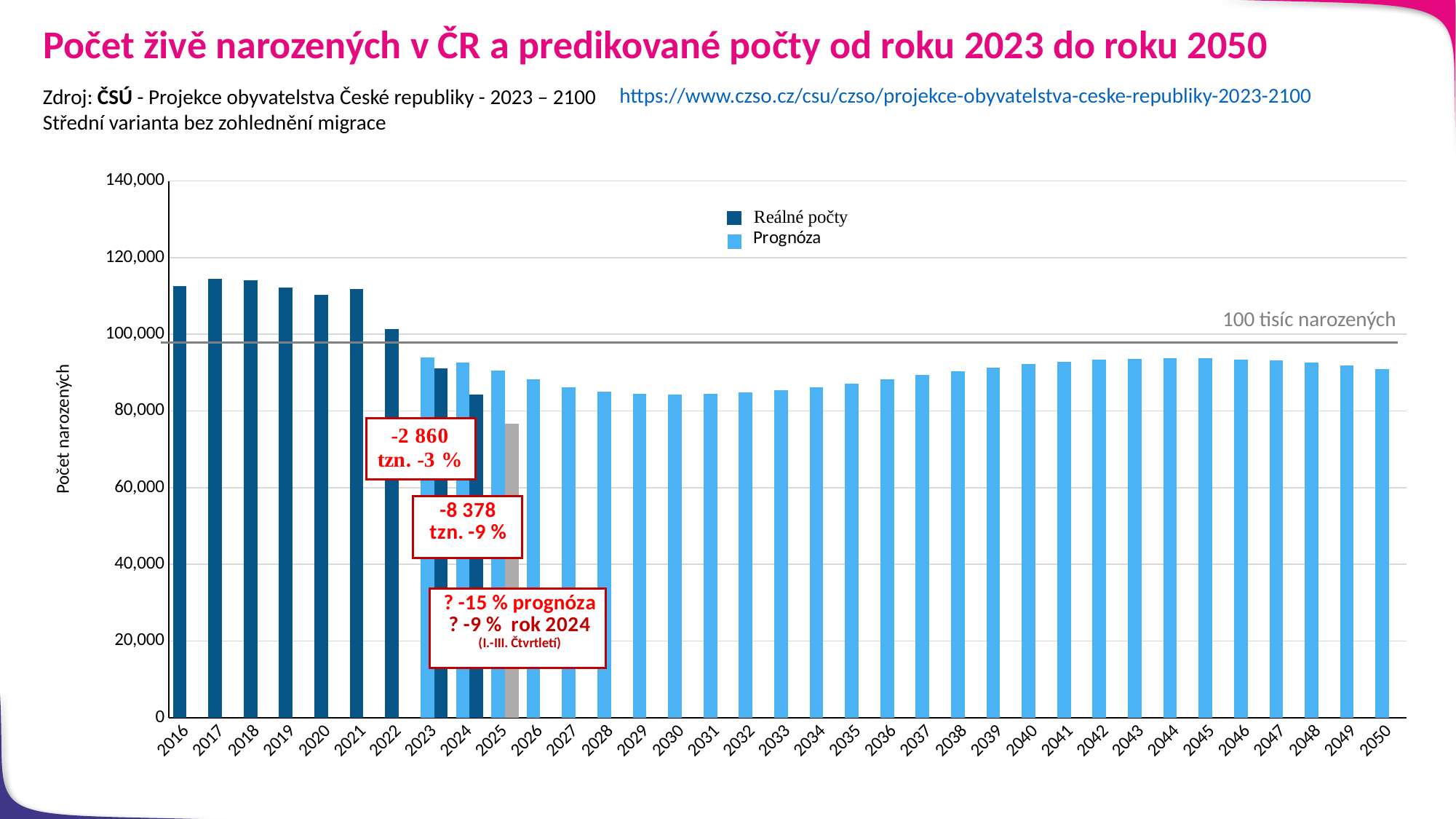
Which is larger, the Prognóza value for 2044 or for 2030? 2044 Is the value for Prognóza in 2050 greater or less than 100,000? less Is the value for Reálné počty in 2024 greater or less than 80,000? greater Is the value for Reálné počty in 2016 greater or less than 100,000? greater Do the Reálné počty values rise or fall from 2016 to 2024? fall How many series does the legend list? 2 What are the two legend entries of the chart? Reálné počty, Prognóza Do the Prognóza values rise or fall from 2030 to 2044? rise How many years are shown on the x axis of the chart? 35 What kind of chart is shown on the slide? bar chart Which is larger, the Reálné počty value for 2016 or for 2024? 2016